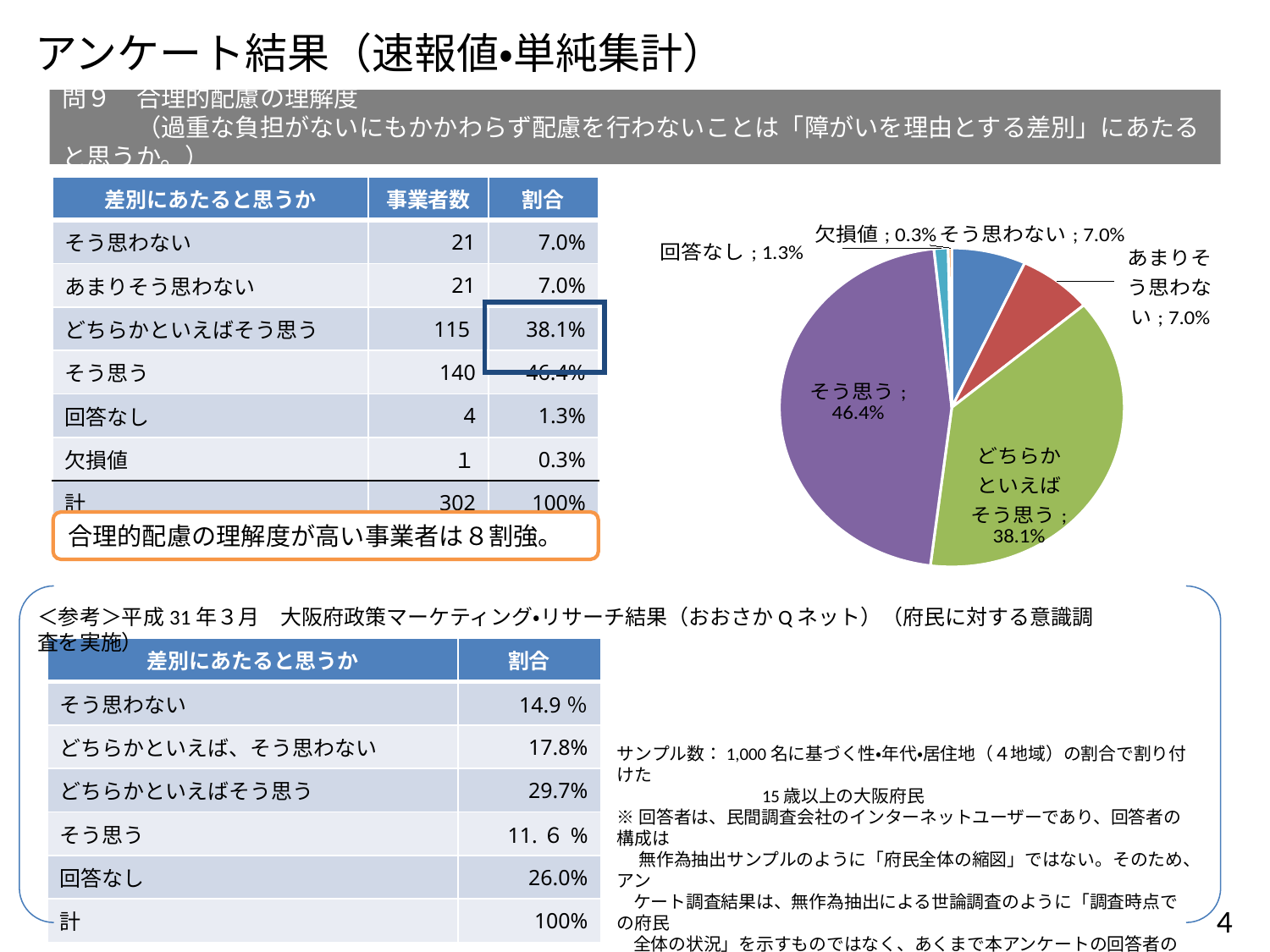
What is the difference in percentage points between そう思う and どちらかといえばそう思う in the pie chart? 8.3 What is the share for 欠損値 in the pie chart? 0.3% What is the share for そう思う in the pie chart? 46.4% What kind of chart is shown on the slide? pie chart Which slice of the pie chart is the smallest? 欠損値 What colour is the そう思う slice in the pie chart? purple What is the share for 回答なし in the pie chart? 1.3% In the pie chart, which is larger: そう思う or どちらかといえばそう思う? そう思う What is the share for どちらかといえばそう思う in the pie chart? 38.1% How many slices does the pie chart have? 6 Which slice of the pie chart is the largest? そう思う What is the share for そう思わない in the pie chart? 7.0%